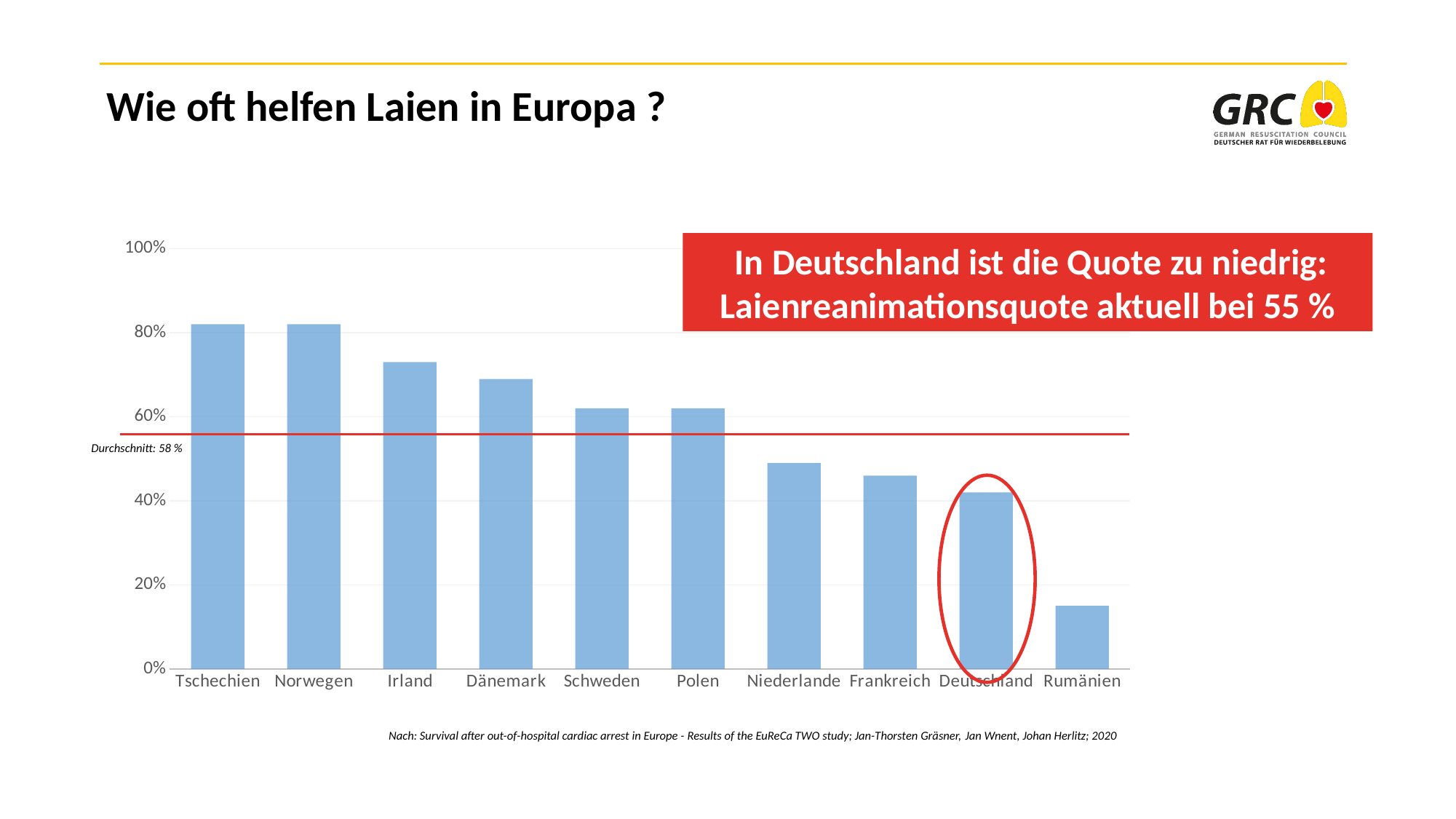
Is the value for Niederlande greater or less than 60%? less Which has the larger value, Irland or Niederlande? Irland Is the value for Irland greater or less than 60%? greater Do the bar values generally rise or fall from left to right along the x axis? fall Is the value for Rumänien greater or less than 20%? less What average value (Durchschnitt) is marked by the horizontal red line in the chart? 58 % What kind of chart is shown on the slide? bar chart Which country has the lowest value in the chart? Rumänien How many countries are shown on the x axis of the chart? 10 Which has the larger value, Frankreich or Rumänien? Frankreich